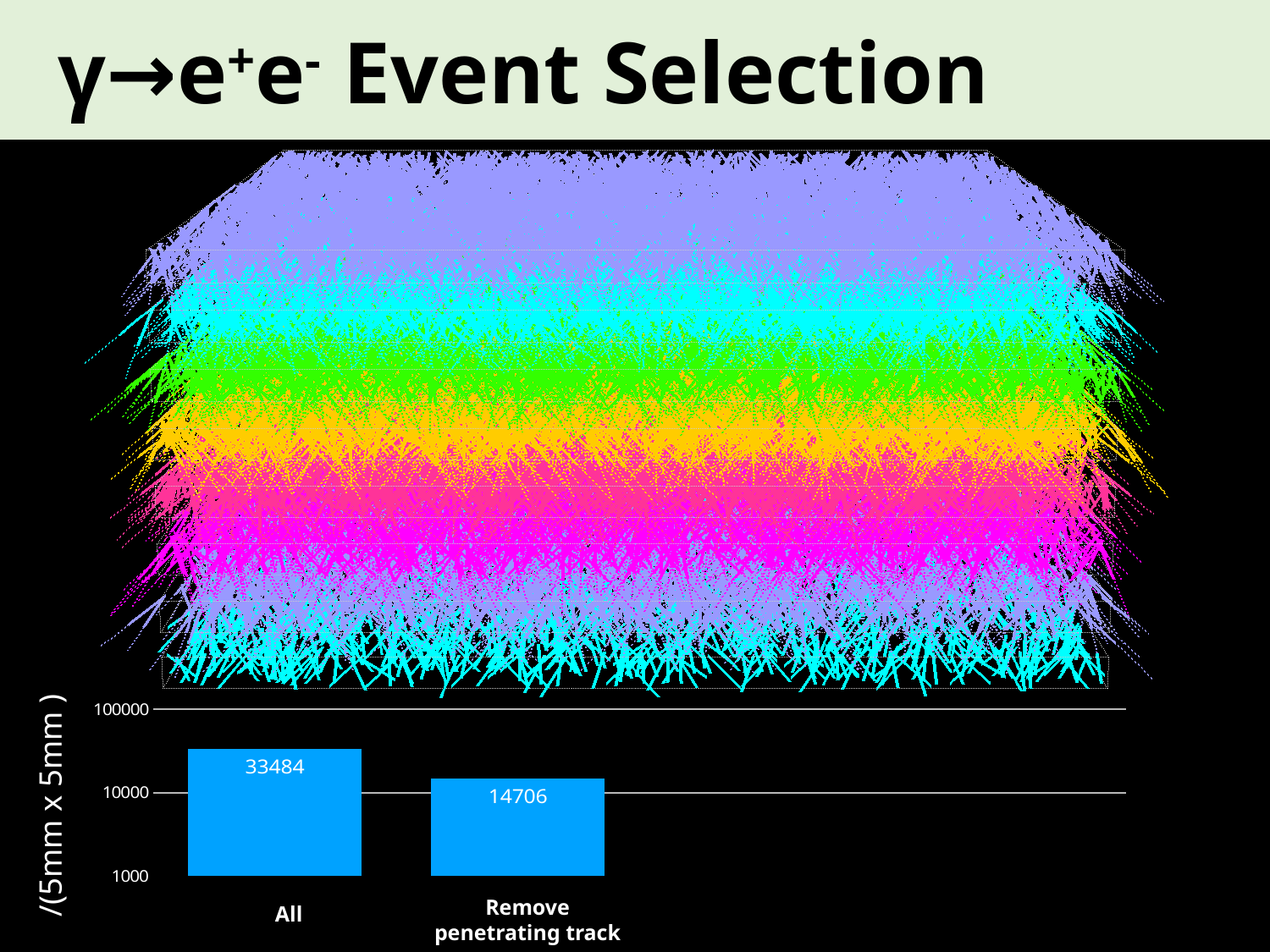
Is the value for "Remove penetrating track" greater or less than 100000? less How many categories are shown in the bar chart? 2 What is the value for the "All" bar in the bar chart? 33484 Which category has the lowest value in the bar chart? Remove penetrating track What kind of chart is shown at the bottom of the slide? Bar chart What is the label on the y axis of the bar chart? /(5mm x 5mm ) What is the value for the "Remove penetrating track" bar in the bar chart? 14706 What is the difference between the "All" value and the "Remove penetrating track" value in the bar chart? 18778 Do the values fall or rise from the first bar to the second bar in the bar chart? Fall Which category has the highest value in the bar chart? All Which is larger in the bar chart: the value for "All" or the value for "Remove penetrating track"? All Is the value for "All" greater or less than 10000? greater